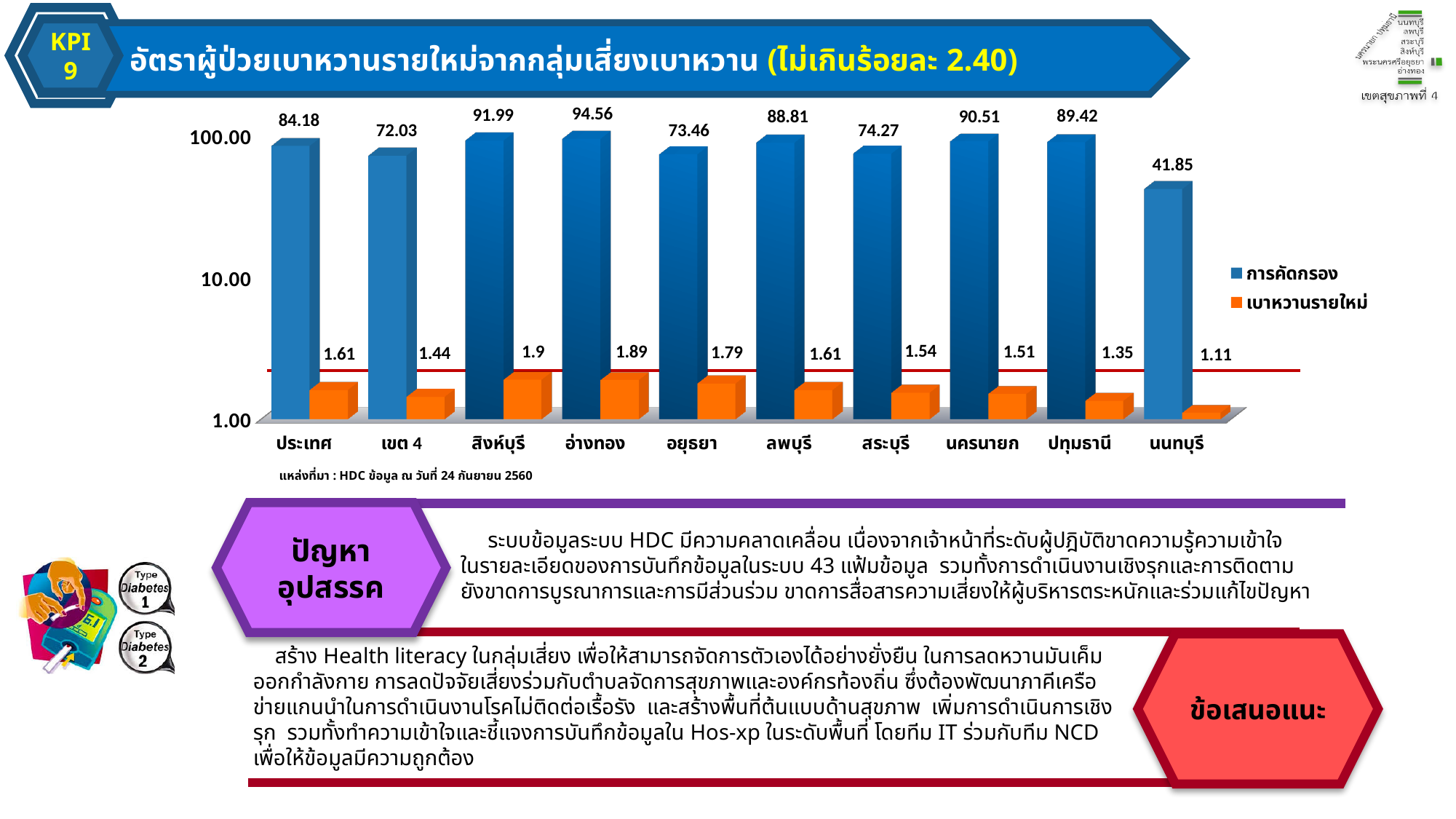
Which category has the lowest การคัดกรอง value? นนทบุรี Which category has the highest เบาหวานรายใหม่ value? สิงห์บุรี What is the value of การคัดกรอง for เขต 4? 72.03 What is the difference between the การคัดกรอง values for สิงห์บุรี and นนทบุรี? 50.14 How many series does the legend list? 2 Which is larger, the เบาหวานรายใหม่ value for ปทุมธานี or for สระบุรี? สระบุรี Which category has the highest การคัดกรอง value? อ่างทอง What is the value of การคัดกรอง for อ่างทอง? 94.56 How many categories are shown on the x axis? 10 Is the การคัดกรอง value for นนทบุรี greater or less than 10.00? greater What kind of chart is shown on the slide? bar chart What is the value of เบาหวานรายใหม่ for นนทบุรี? 1.11